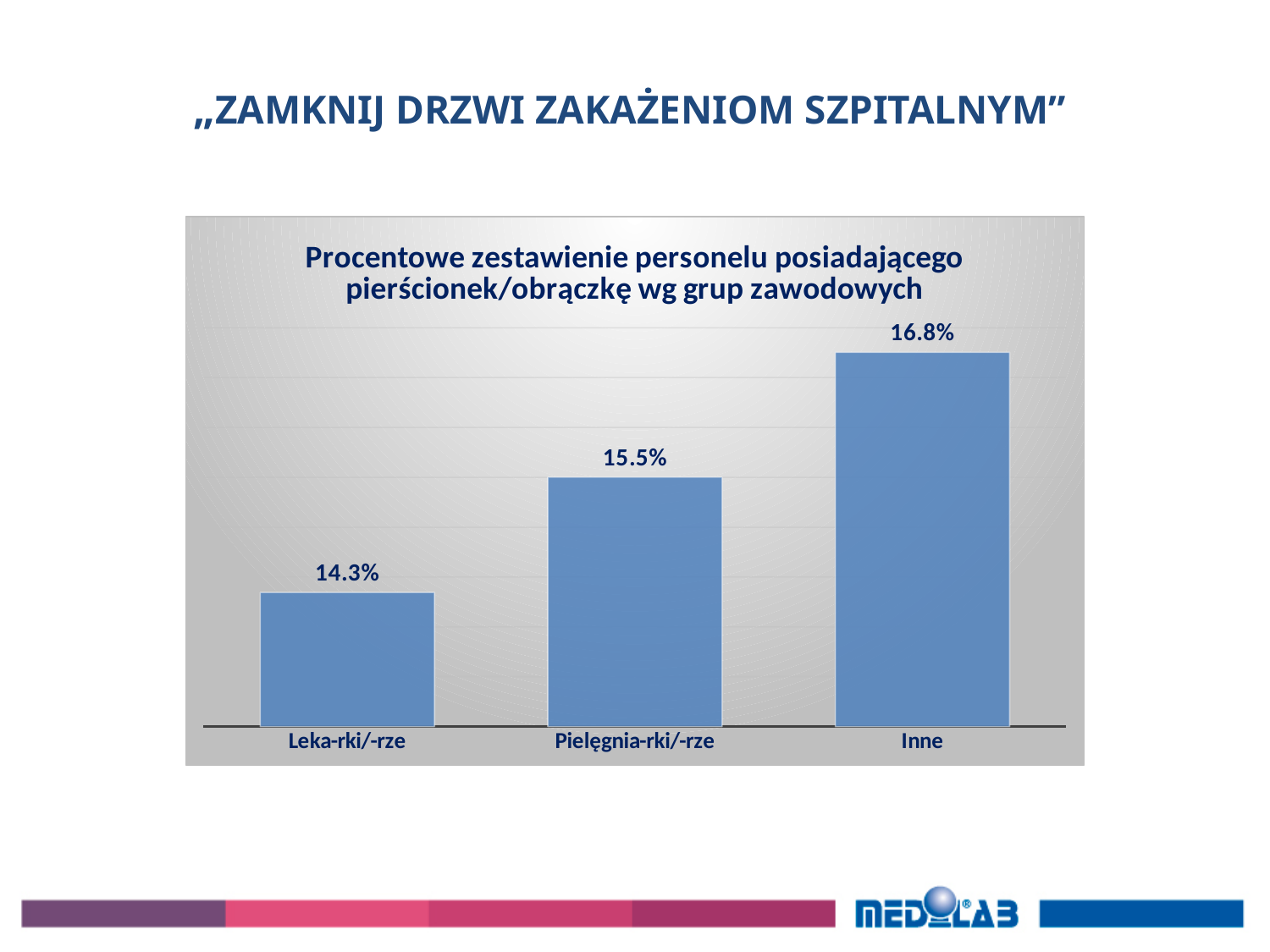
What is the difference between the values for Pielęgnia-rki/-rze and Leka-rki/-rze? 1.2% What kind of chart is shown on the slide? Bar chart What is the title of the chart? Procentowe zestawienie personelu posiadającego pierścionek/obrączkę wg grup zawodowych What is the value for Leka-rki/-rze? 14.3% What is the value for Pielęgnia-rki/-rze? 15.5% Do the values rise or fall from left to right along the x axis? Rise Which category has the highest value? Inne How many categories are shown on the x axis? 3 What is the difference between the values for Inne and Leka-rki/-rze? 2.5% Which is larger, the value for Pielęgnia-rki/-rze or the value for Inne? Inne Which category has the lowest value? Leka-rki/-rze What is the value for Inne? 16.8%